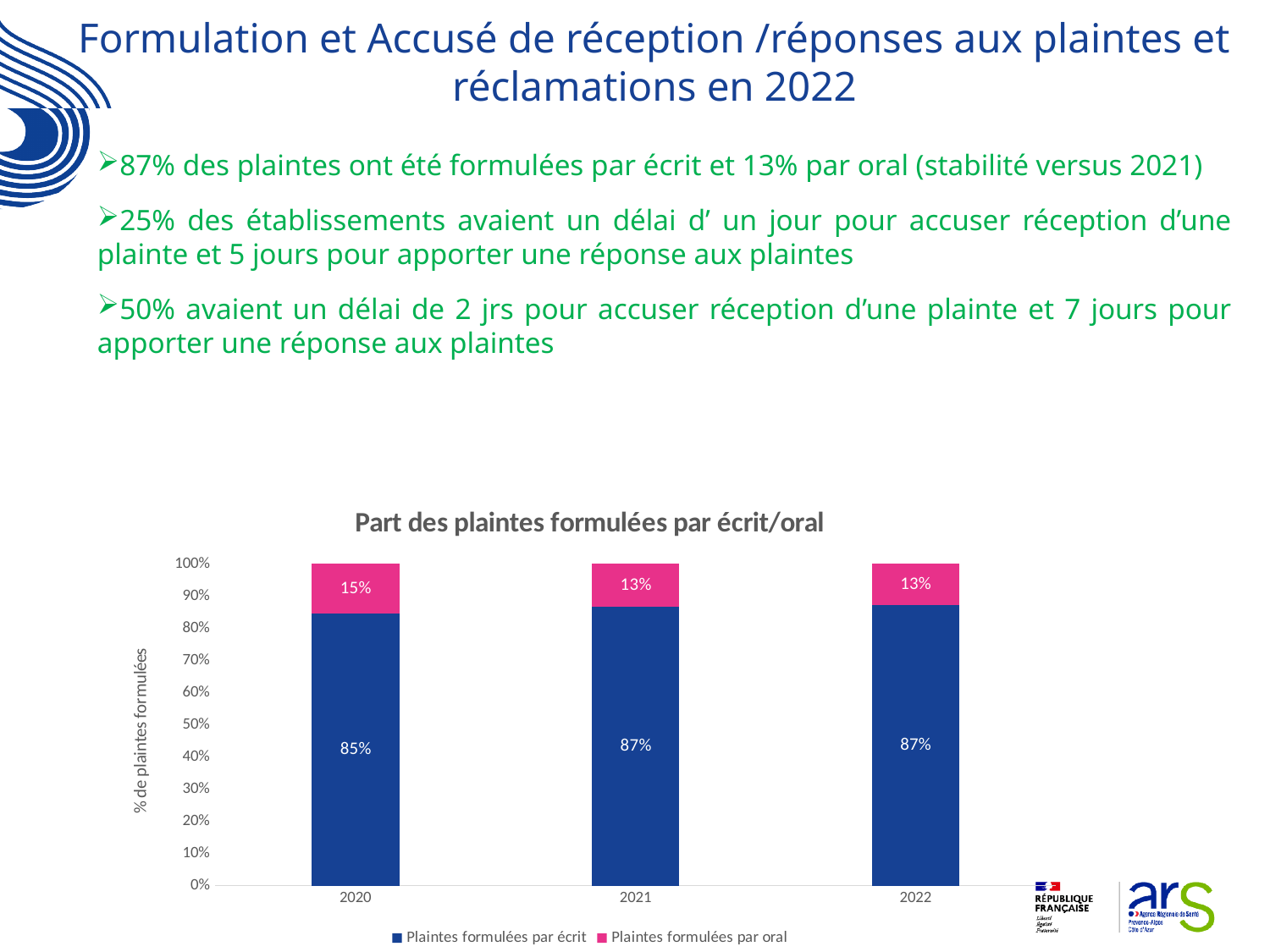
Which year has the lowest share of 'Plaintes formulées par écrit'? 2020 What is the title of the chart? Part des plaintes formulées par écrit/oral How many years are shown on the x axis? 3 Which is larger in 2022: 'Plaintes formulées par écrit' or 'Plaintes formulées par oral'? Plaintes formulées par écrit What type of chart is shown on the slide? Stacked bar chart What is the difference between the 'Plaintes formulées par écrit' values for 2021 and 2020? 2% What is the value for 'Plaintes formulées par oral' in 2020? 15% How many series does the legend list? 2 What is the value for 'Plaintes formulées par écrit' in 2022? 87% Which year has the highest share of 'Plaintes formulées par oral'? 2020 What is the value for 'Plaintes formulées par oral' in 2021? 13% What is the value for 'Plaintes formulées par écrit' in 2020? 85%